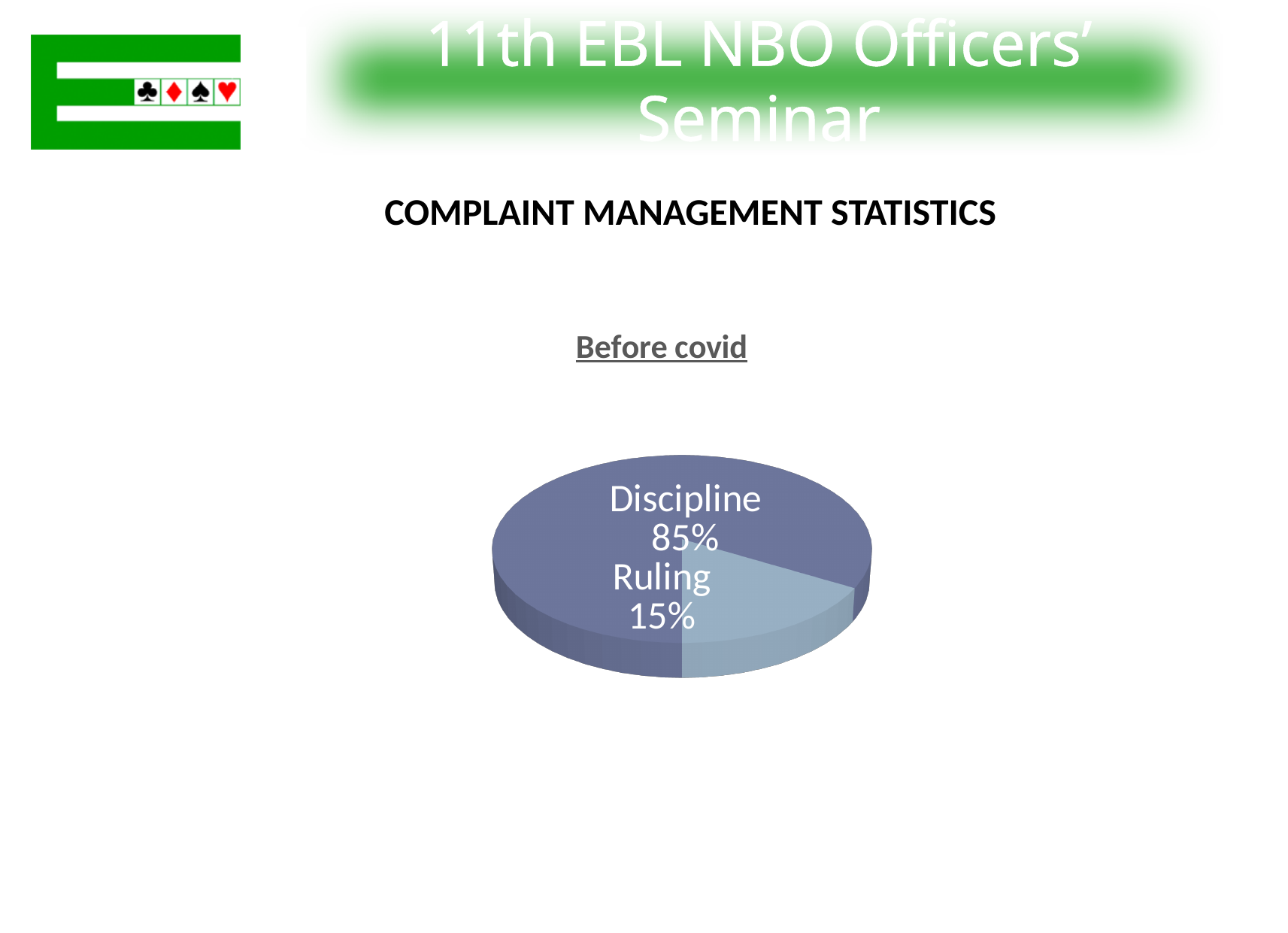
What kind of chart is shown on the slide? pie chart What share of the pie does Discipline account for? 85% What is the heading of the statistics section on the slide? COMPLAINT MANAGEMENT STATISTICS Which is larger, the Discipline slice or the Ruling slice? Discipline Which slice of the pie is the largest? Discipline Which slice of the pie is the smallest? Ruling What is the title shown above the pie chart? Before covid What is the difference in percentage points between the Discipline and Ruling slices? 70 What share of the pie does Ruling account for? 15% How many slices does the pie chart have? 2